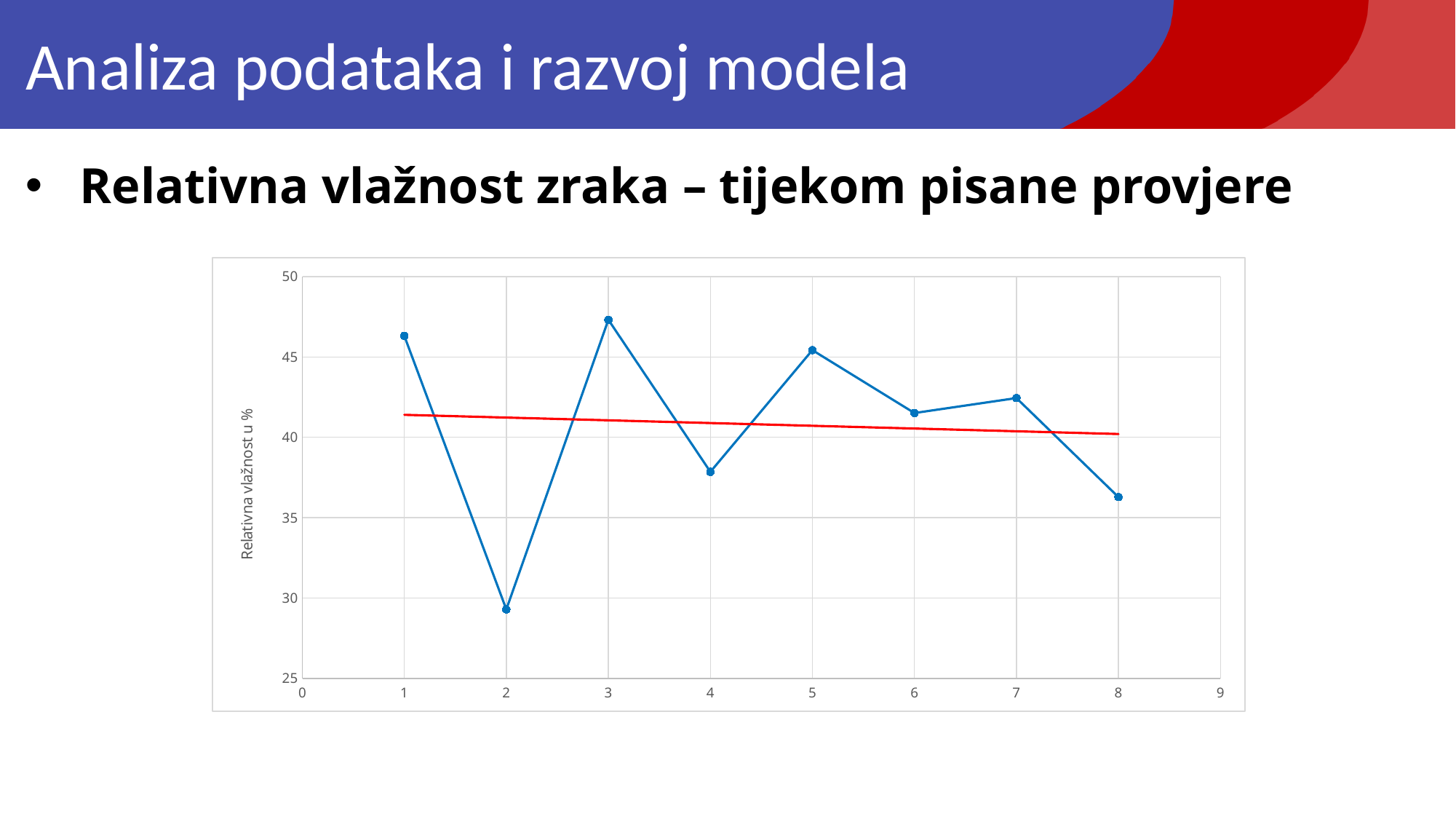
At which x value is the relative humidity lowest? 2 Does the red trend line rise or fall from left to right? fall Which is larger, the value at x = 2 or the value at x = 4? x = 4 Is the value at x = 6 greater or less than 40? greater What kind of chart is shown on the slide? line chart Is the value at x = 8 greater or less than 40? less What is the label of the vertical axis? Relativna vlažnost u % Is the value at x = 2 greater or less than 30? less Which is larger, the value at x = 5 or the value at x = 6? x = 5 How many data points are plotted on the blue line? 8